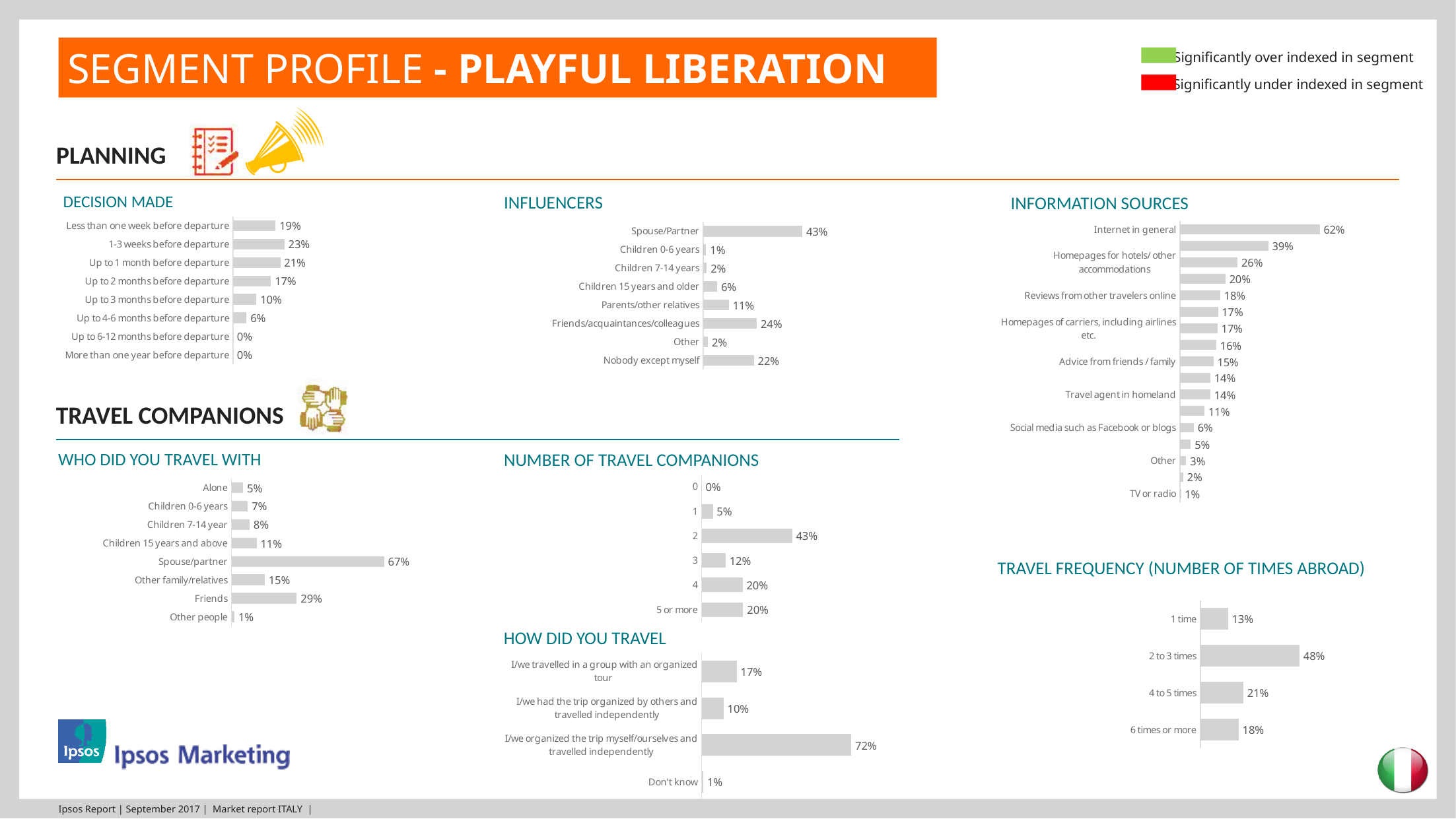
In the NUMBER OF TRAVEL COMPANIONS chart, what is the value for 2 companions? 43% In the WHO DID YOU TRAVEL WITH chart, what is the value for Spouse/partner? 67% In the INFORMATION SOURCES chart, which is larger: Reviews from other travelers online or Travel agent in homeland? Reviews from other travelers online How many categories are shown in the NUMBER OF TRAVEL COMPANIONS chart? 6 In the INFLUENCERS chart, what is the value for Spouse/Partner? 43% In the WHO DID YOU TRAVEL WITH chart, which category has the lowest value? Other people In the DECISION MADE chart, what is the value for 1-3 weeks before departure? 23% In the HOW DID YOU TRAVEL chart, what is the value for 'I/we organized the trip myself/ourselves and travelled independently'? 72% What type of chart is the TRAVEL FREQUENCY (NUMBER OF TIMES ABROAD) chart? Bar chart In the INFLUENCERS chart, what is the difference between Friends/acquaintances/colleagues and Nobody except myself? 2% In the INFORMATION SOURCES chart, what is the value for Internet in general? 62% In the DECISION MADE chart, which category has the highest value? 1-3 weeks before departure